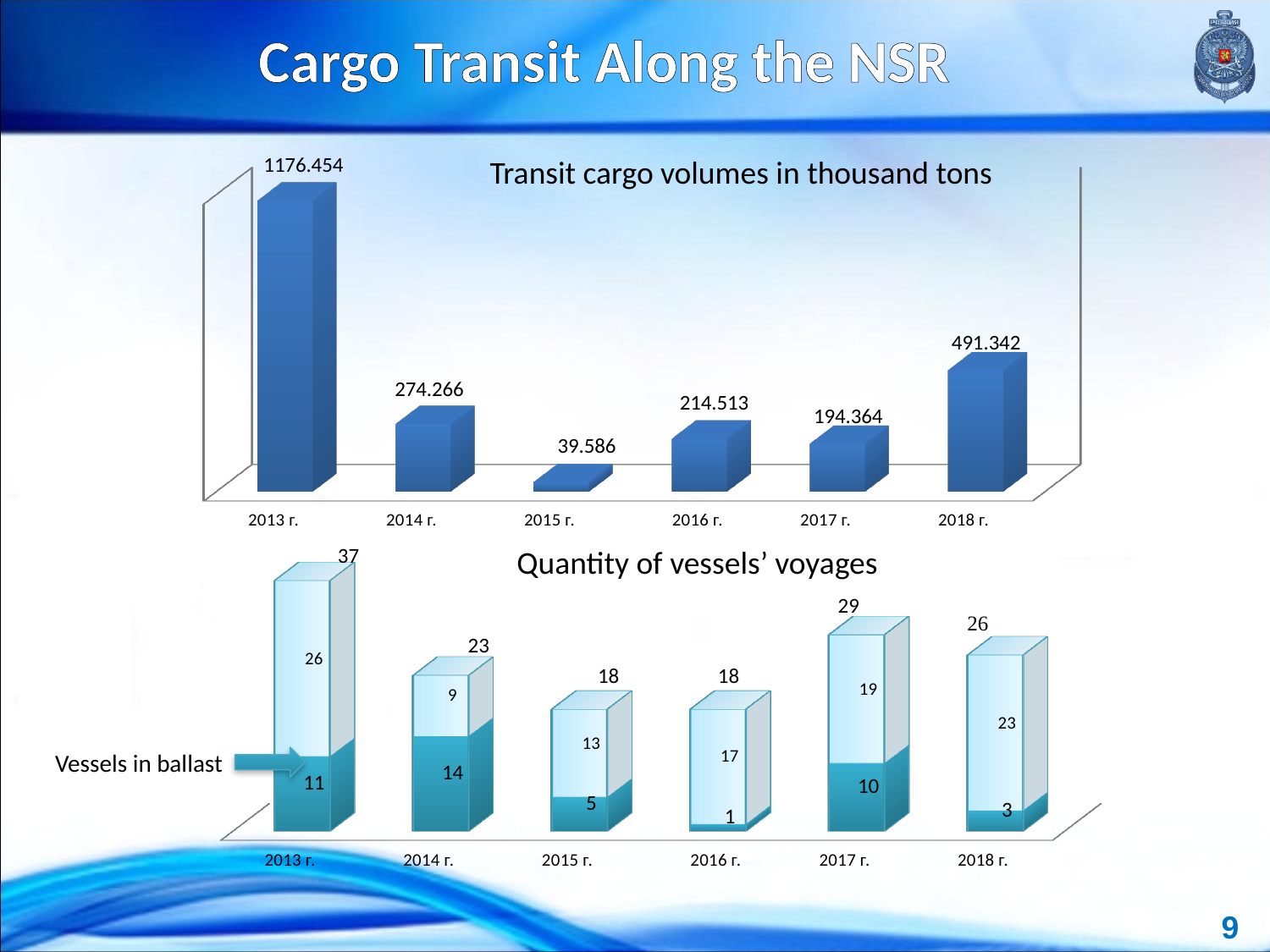
In the 'Quantity of vessels' voyages' chart, what is the total for 2013 г.? 37 In the 'Quantity of vessels' voyages' chart, how many vessels in ballast are shown for 2016 г.? 1 How many years are shown in the 'Transit cargo volumes in thousand tons' chart? 6 In the 'Transit cargo volumes in thousand tons' chart, which year has the highest value? 2013 г. In the 'Transit cargo volumes in thousand tons' chart, which is larger, the value for 2016 г. or 2017 г.? 2016 г. In the 'Transit cargo volumes in thousand tons' chart, what is the difference between the values for 2014 г. and 2017 г.? 79.902 In the 'Quantity of vessels' voyages' chart, what is the value of the upper (light) segment for 2018 г.? 23 In the 'Transit cargo volumes in thousand tons' chart, which year has the lowest value? 2015 г. In the 'Transit cargo volumes in thousand tons' chart, what is the value for 2013 г.? 1176.454 In the 'Quantity of vessels' voyages' chart, which year has the highest total? 2013 г. In the 'Transit cargo volumes in thousand tons' chart, what is the value for 2018 г.? 491.342 What kind of chart is 'Quantity of vessels' voyages'? Stacked bar chart